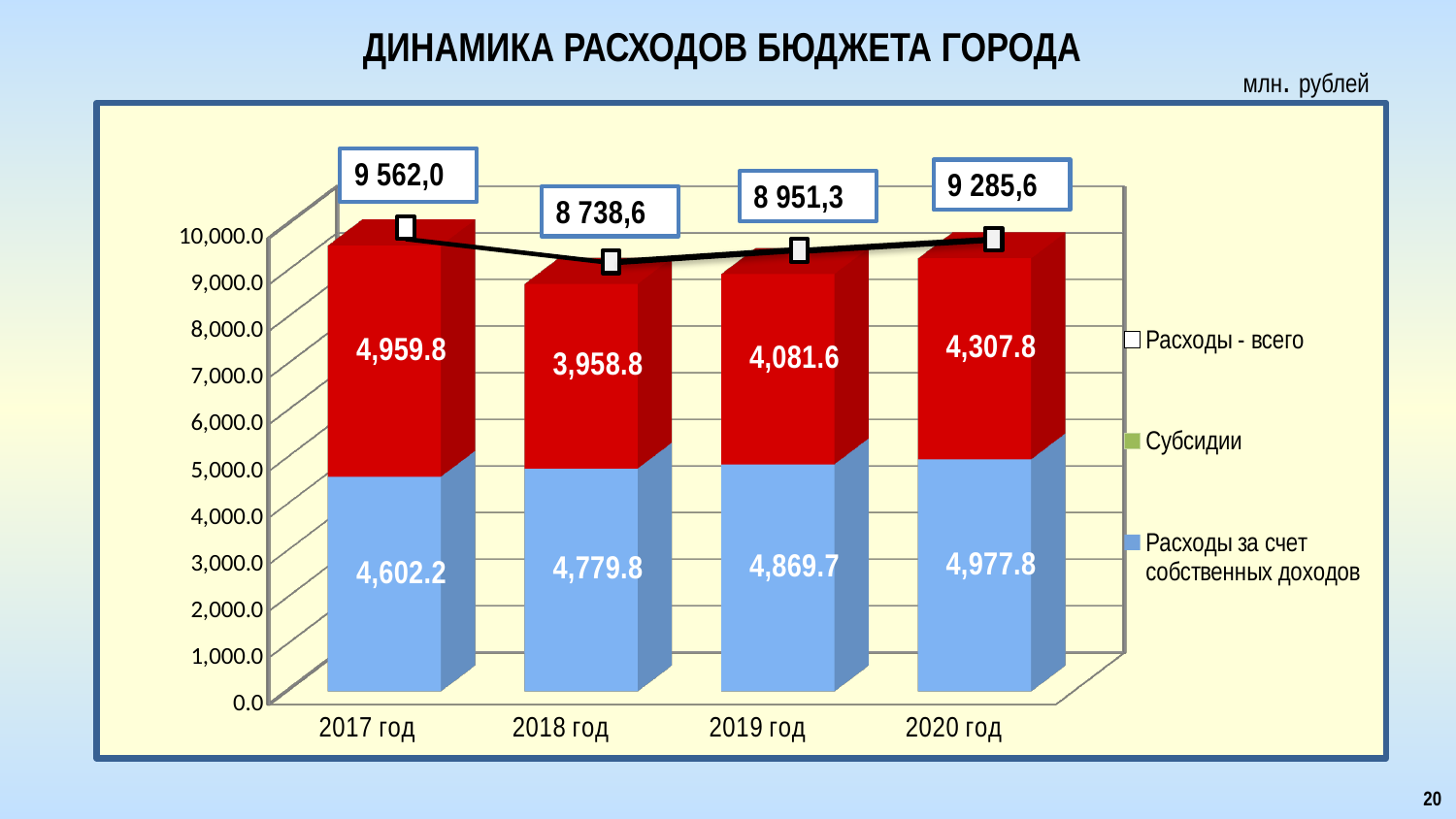
How many years are shown on the x axis? 4 What is the total of the stacked bar for 2020 год? 9 285,6 Do the values of Расходы за счет собственных доходов rise or fall from 2017 год to 2020 год? Rise In which year is Расходы - всего the highest? 2017 год What is the value of Расходы - всего for 2019 год? 8 951,3 What is the value of Расходы за счет собственных доходов for 2017 год? 4,602.2 In which year is Расходы - всего the lowest? 2018 год How many series does the legend list? 3 What kind of chart is shown on the slide? Stacked bar chart with a line By how much does Расходы за счет собственных доходов in 2020 год exceed that in 2017 год? 375.6